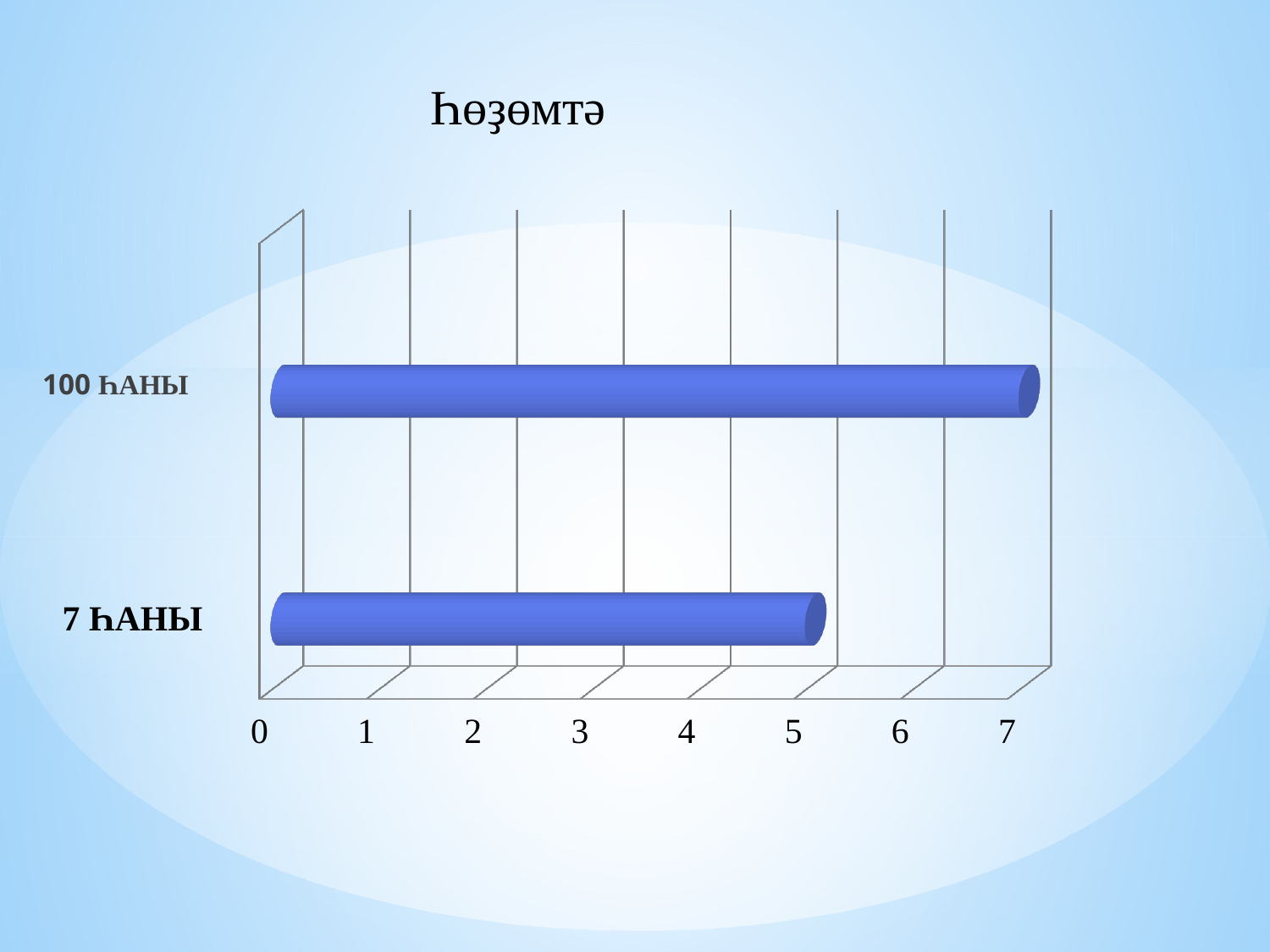
Which is larger, the value for 100 ҺАНЫ or the value for 7 ҺАНЫ? 100 ҺАНЫ How many categories are plotted in the chart? 2 What is the highest tick value shown on the horizontal axis? 7 Which category has the lowest value? 7 ҺАНЫ Is the value for 7 ҺАНЫ greater or less than 6? less Which category has the highest value? 100 ҺАНЫ What kind of chart is shown on the slide? bar chart Is the value for 100 ҺАНЫ greater or less than 6? greater What is the title of the chart? Һөҙөмтә Is the value for 7 ҺАНЫ greater or less than 4? greater